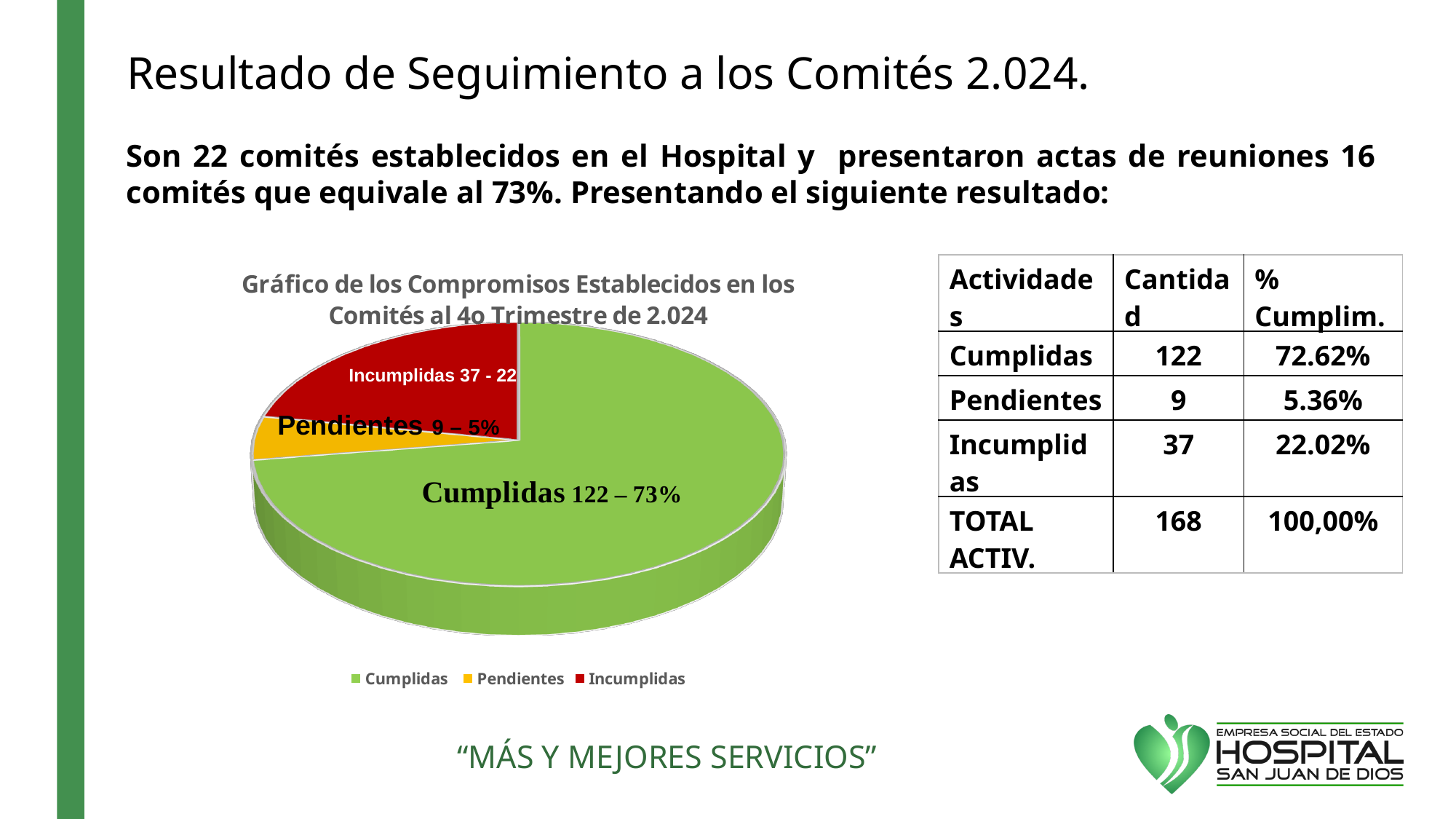
How many entries does the pie chart legend list? 3 Which slice of the pie chart is the largest? Cumplidas What is the value shown for Pendientes in the pie chart? 9 What colour is the Incumplidas slice in the pie chart? Red What percentage share of the pie does Incumplidas represent? 22% What percentage share of the pie does Pendientes represent? 5% What percentage share of the pie does Cumplidas represent? 73% What type of chart is shown on the slide? Pie chart What is the difference between the Cumplidas value and the Incumplidas value in the pie chart? 85 Which slice of the pie chart is the smallest? Pendientes What is the value shown for Cumplidas in the pie chart? 122 What is the value shown for Incumplidas in the pie chart? 37